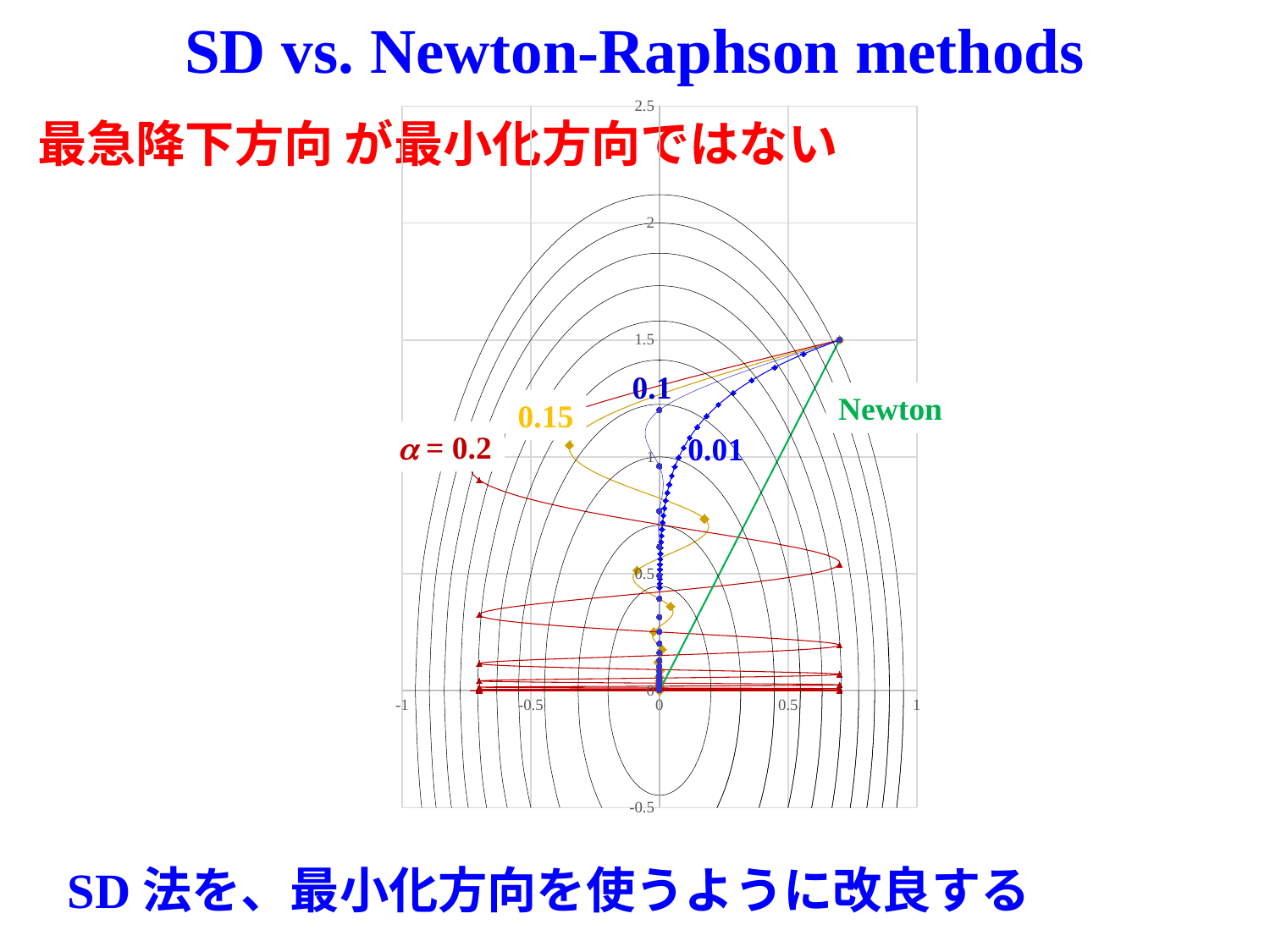
Do the trajectories move toward higher or lower y values as they progress? lower Is the x-coordinate of the common starting point greater or less than 0.5? greater What is the y-coordinate of the common starting point of all trajectories? 1.5 What is the title of the slide containing the chart? SD vs. Newton-Raphson methods Which trajectory reaches the minimum in a single straight step? Newton What is the highest value shown on the y axis? 2.5 How many labelled trajectories are drawn on the chart? 5 Which trajectory oscillates most widely in the x direction? α = 0.2 Which labelled step size produces the trajectory that stays closest to the x = 0 line? 0.01 What kind of chart is shown on the slide? line chart What is the lowest value shown on the x axis? -1 Which trajectory on the chart is labelled in green? Newton